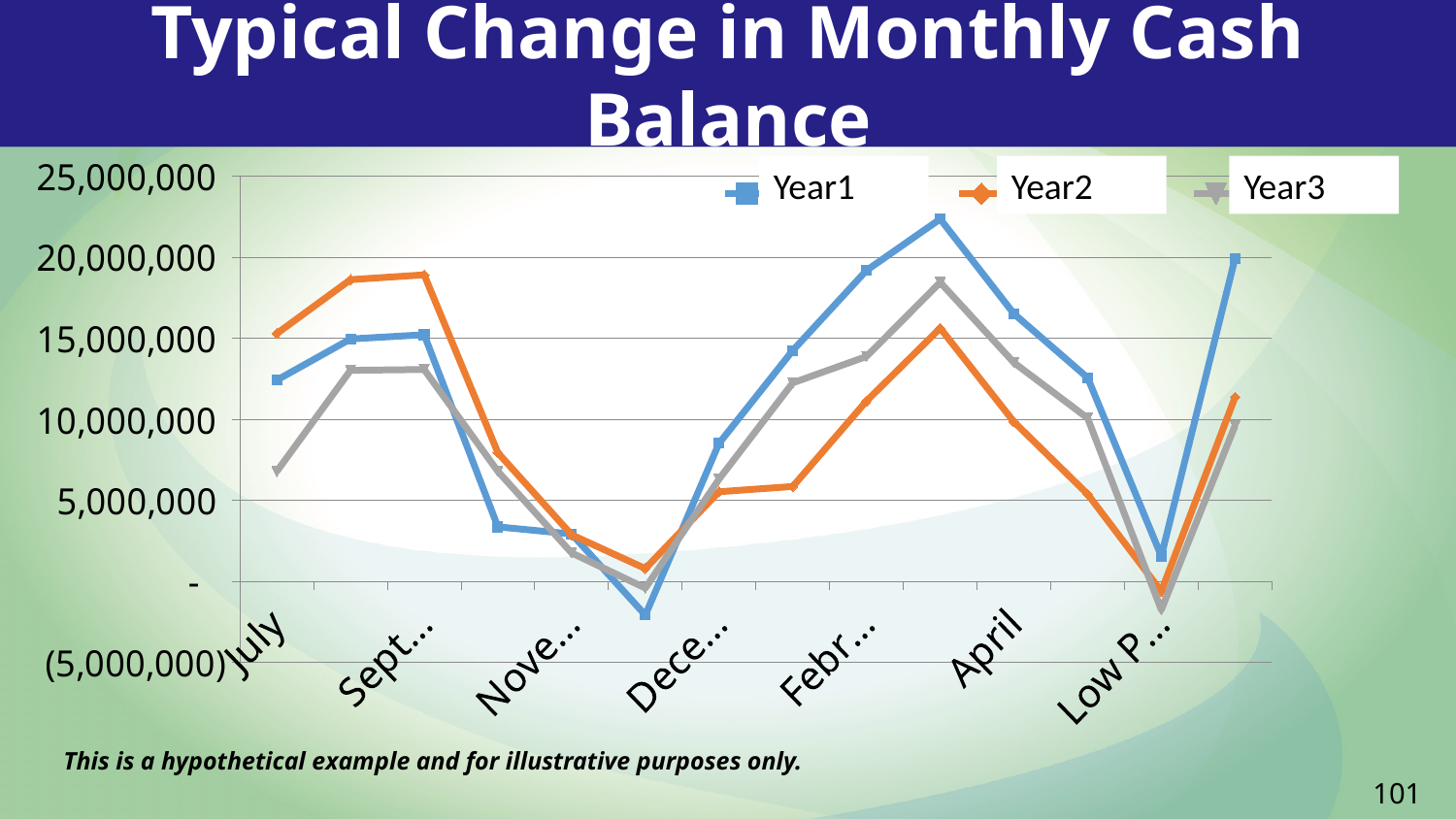
Which series has the lowest value at April? Year2 What kind of chart is shown on the slide? line chart What is the title of the chart? Typical Change in Monthly Cash Balance Which series has the lowest value at July? Year3 Does the Year1 line rise or fall from July to Sept...? rise At April, which is larger: Year3 or Year2? Year3 How many series does the legend list? 3 Which series has the highest value at April? Year1 Which series reaches the highest value anywhere on the chart? Year1 Which series has the highest value at July? Year2 Is the value for Year3 at July greater or less than 10,000,000? less Is the value for Year1 at July greater or less than 10,000,000? greater